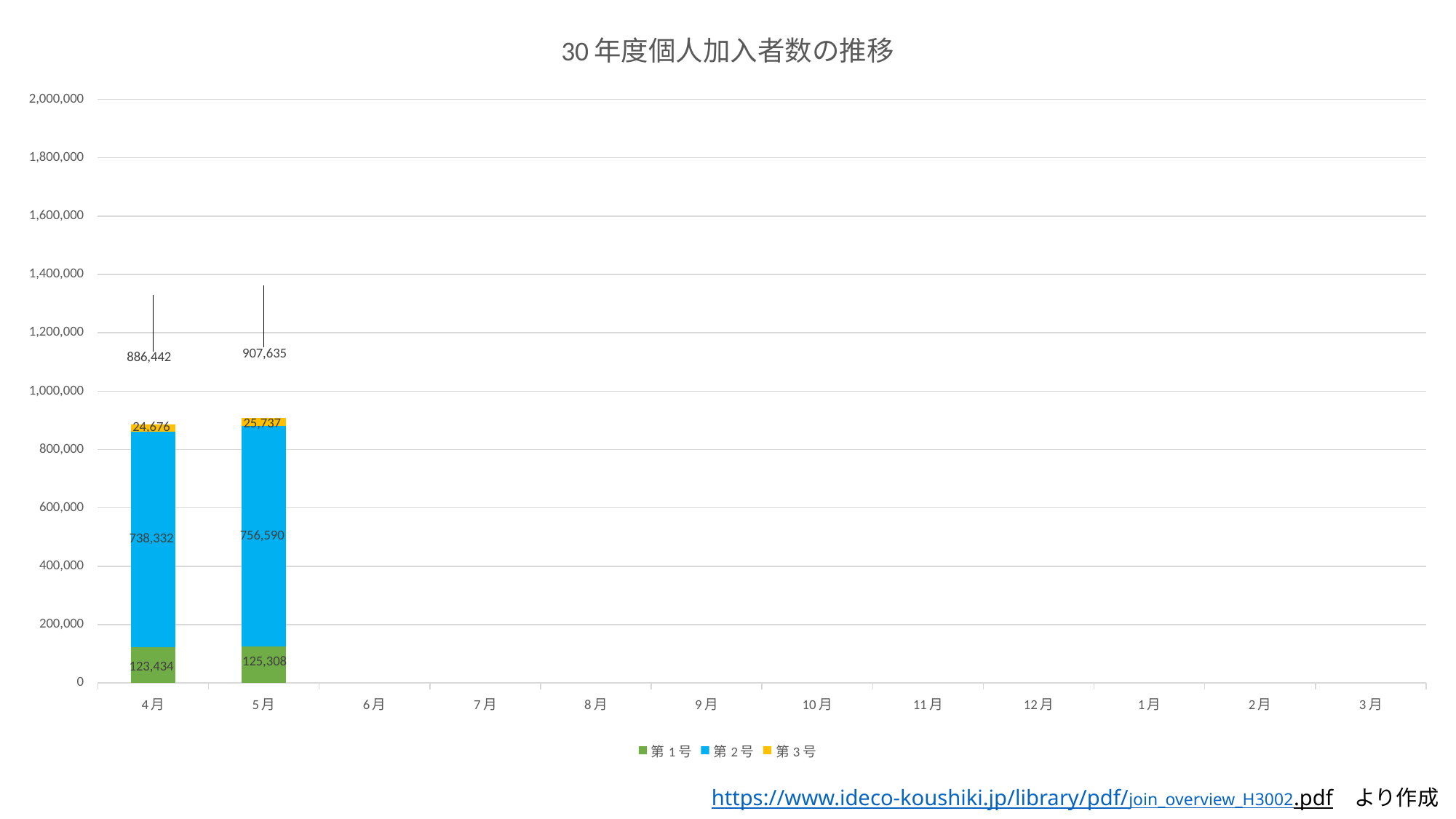
What is the value of 第2号 for 4月? 738,332 What is the total of the stacked bar for 5月? 907,635 Is the 第1号 value for 4月 larger or smaller than the 第1号 value for 5月? smaller How many series does the legend list? 3 What is the difference between the 第2号 values for 5月 and 4月? 18,258 What is the difference between the totals for 5月 and 4月? 21,193 Which series has the largest value in 5月? 第2号 What is the value of 第3号 for 5月? 25,737 What is the value of 第1号 for 5月? 125,308 Which series has the smallest value in 4月? 第3号 What kind of chart is shown on the slide? Stacked bar chart What is the total of the stacked bar for 4月? 886,442